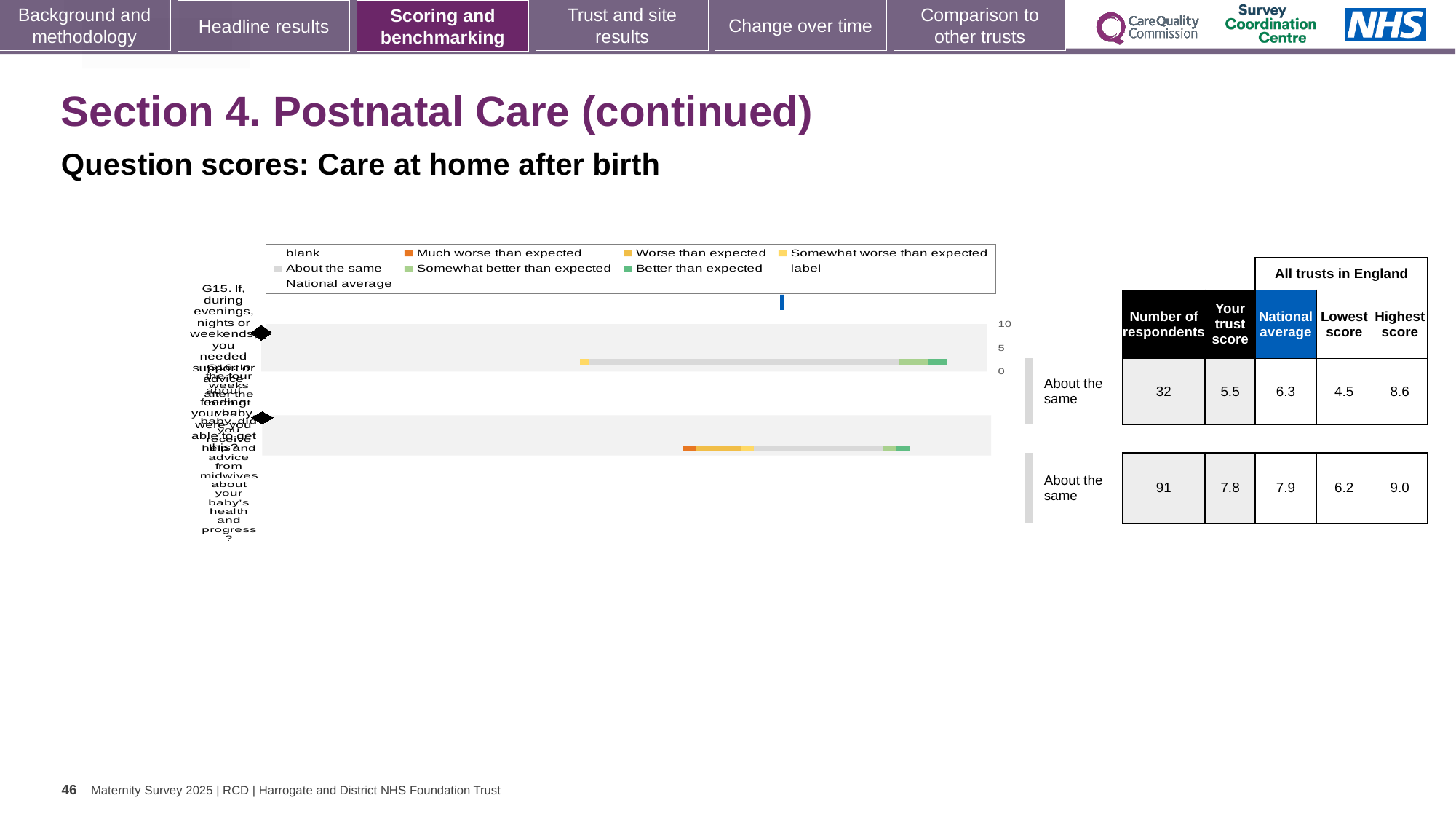
In the table, what is the 'Your trust score' for the first (top) question row? 5.5 What is the difference between the highest and lowest scores for the bottom question row? 2.8 Which question row has more respondents, the top row or the bottom row? the bottom row What is the difference between the national average and the trust score for the top question row? 0.8 In the table, what is the national average for the first (top) question row? 6.3 What benchmark category label is shown next to both question rows? About the same In the table, what is the number of respondents for the first (top) question row? 32 In the table, what is the lowest score for the second (bottom) question row? 6.2 How many question bars are plotted in the chart? 2 Which row has the higher 'Your trust score', the top row or the bottom row? the bottom row In the table, what is the highest score for the second (bottom) question row? 9.0 What kind of chart is shown on the slide? bar chart